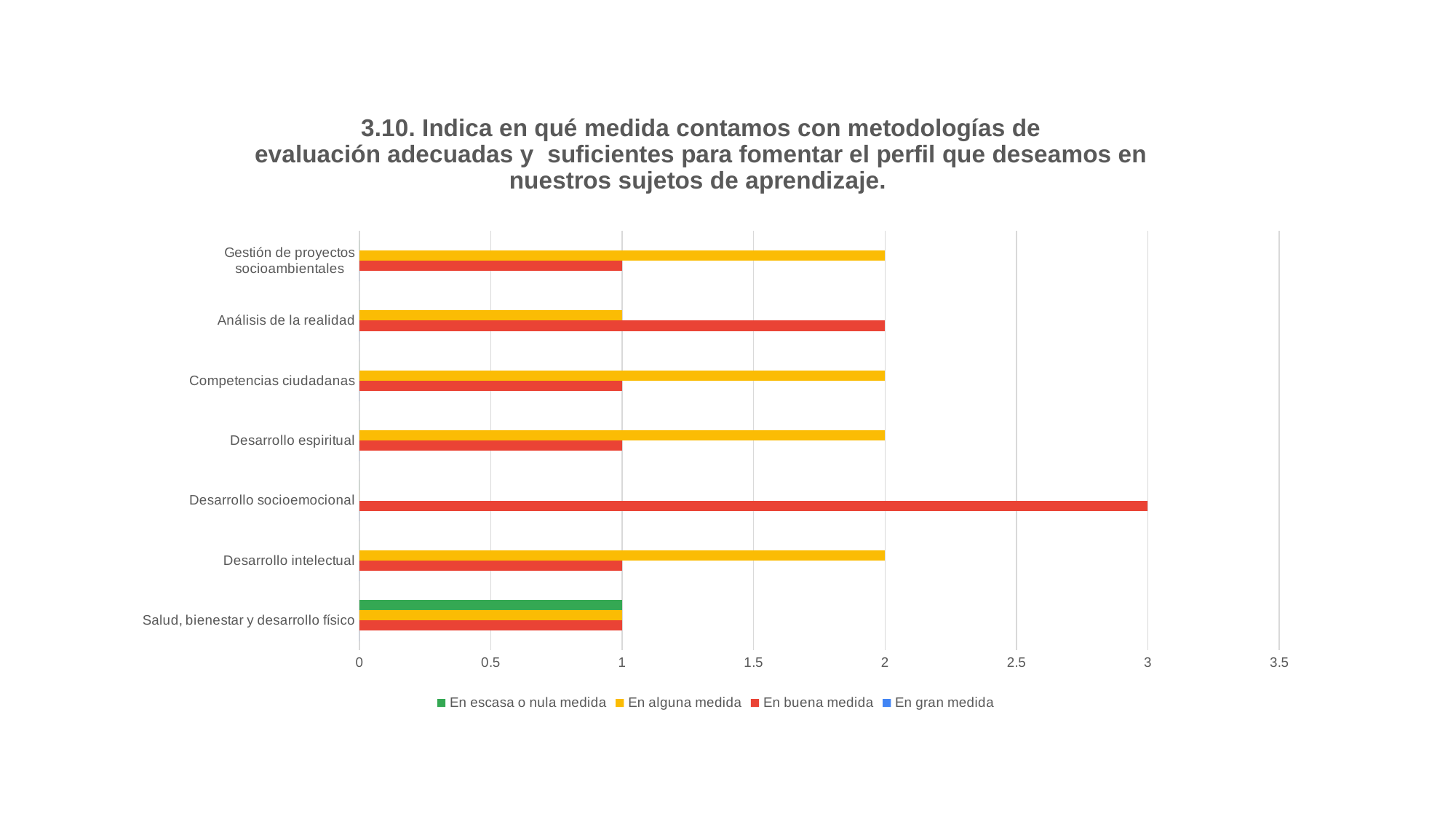
Which category is the only one with a bar for "En escasa o nula medida"? Salud, bienestar y desarrollo físico Which category has the highest value for "En buena medida"? Desarrollo socioemocional What is the value of "En buena medida" for Desarrollo socioemocional? 3 What colour represents "En buena medida" in the legend? red How many series does the legend list? 4 How many categories are listed on the vertical axis of the chart? 7 What is the difference between the "En buena medida" value for Desarrollo socioemocional and the "En buena medida" value for Desarrollo intelectual? 2 What kind of chart is shown on the slide? bar chart What is the value of "En alguna medida" for Gestión de proyectos socioambientales? 2 What is the value of "En escasa o nula medida" for Salud, bienestar y desarrollo físico? 1 What is the value of "En buena medida" for Análisis de la realidad? 2 For Competencias ciudadanas, which is larger: "En alguna medida" or "En buena medida"? En alguna medida